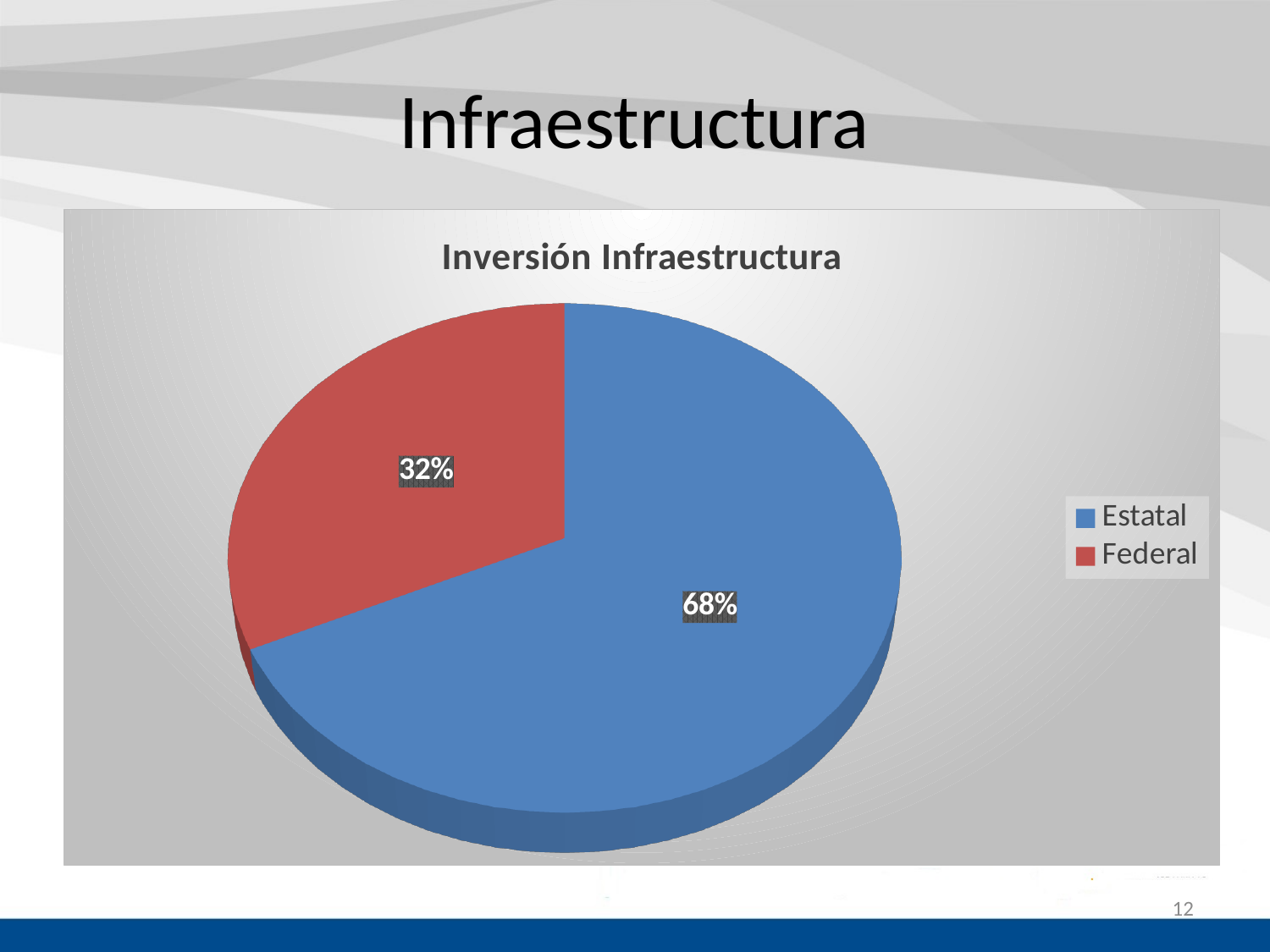
What share of the pie does Federal represent? 32% What is the difference in percentage points between the Estatal and Federal slices? 36 How many slices does the pie chart have? 2 How many entries does the legend list? 2 What colour is the Federal slice? red Which category has the smallest slice of the pie? Federal What is the title of the chart? Inversión Infraestructura Which is larger, the Estatal slice or the Federal slice? Estatal What type of chart is shown on the slide? pie chart Which category has the largest slice of the pie? Estatal What share of the pie does Estatal represent? 68%